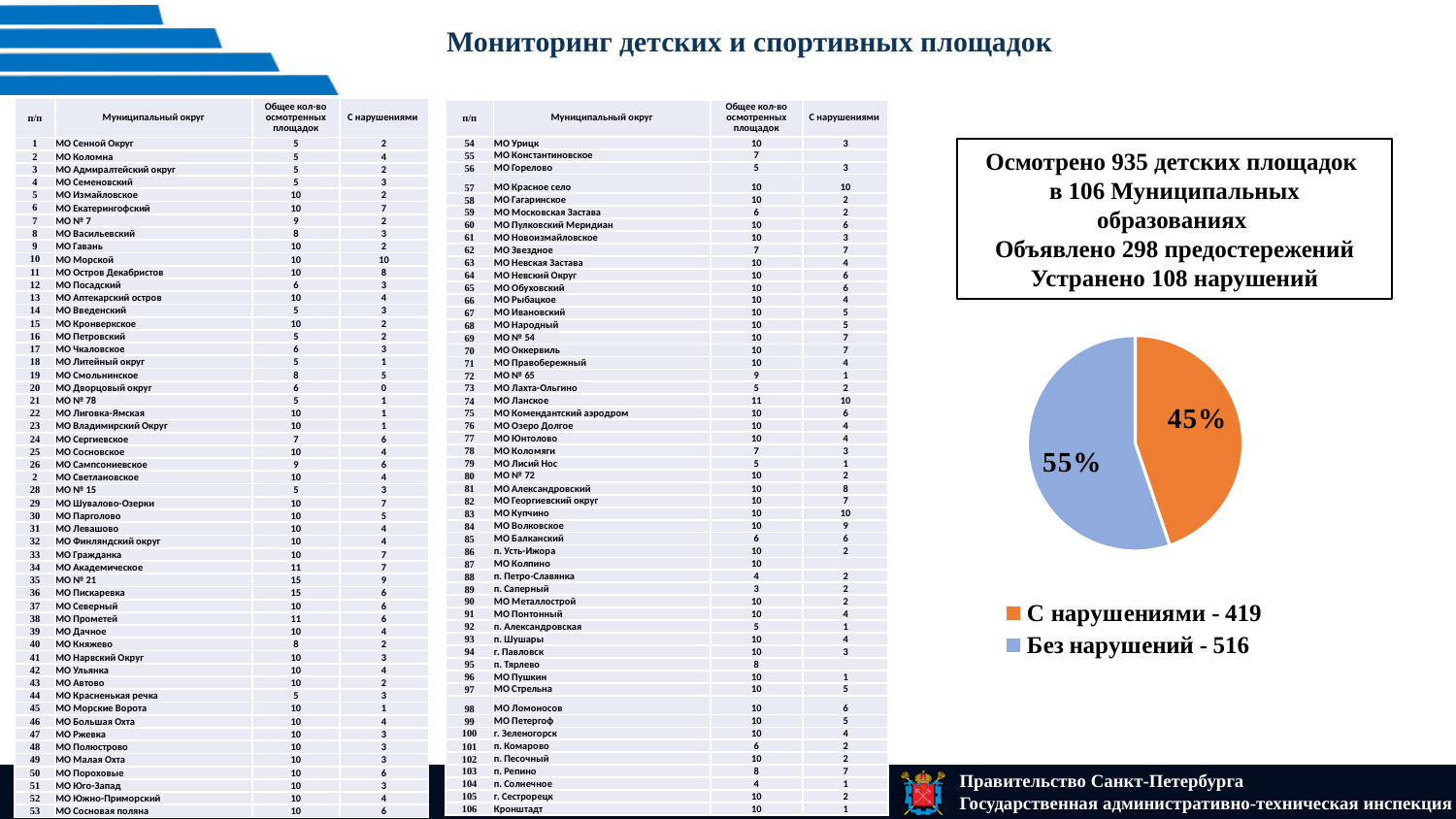
How many slices does the pie chart have? 2 Which is larger in the pie chart, "С нарушениями" or "Без нарушений"? Без нарушений How many entries does the pie chart's legend list? 2 Which slice of the pie chart is the largest? Без нарушений What is the difference between the values for "Без нарушений" and "С нарушениями" in the pie chart legend? 97 What colour is the "С нарушениями" slice in the pie chart? orange According to the pie chart legend, what is the value for "Без нарушений"? 516 Which slice of the pie chart is the smallest? С нарушениями What share of the pie does the slice "Без нарушений" represent? 55% What kind of chart is shown on the slide? pie chart What share of the pie does the slice "С нарушениями" represent? 45% According to the pie chart legend, what is the value for "С нарушениями"? 419